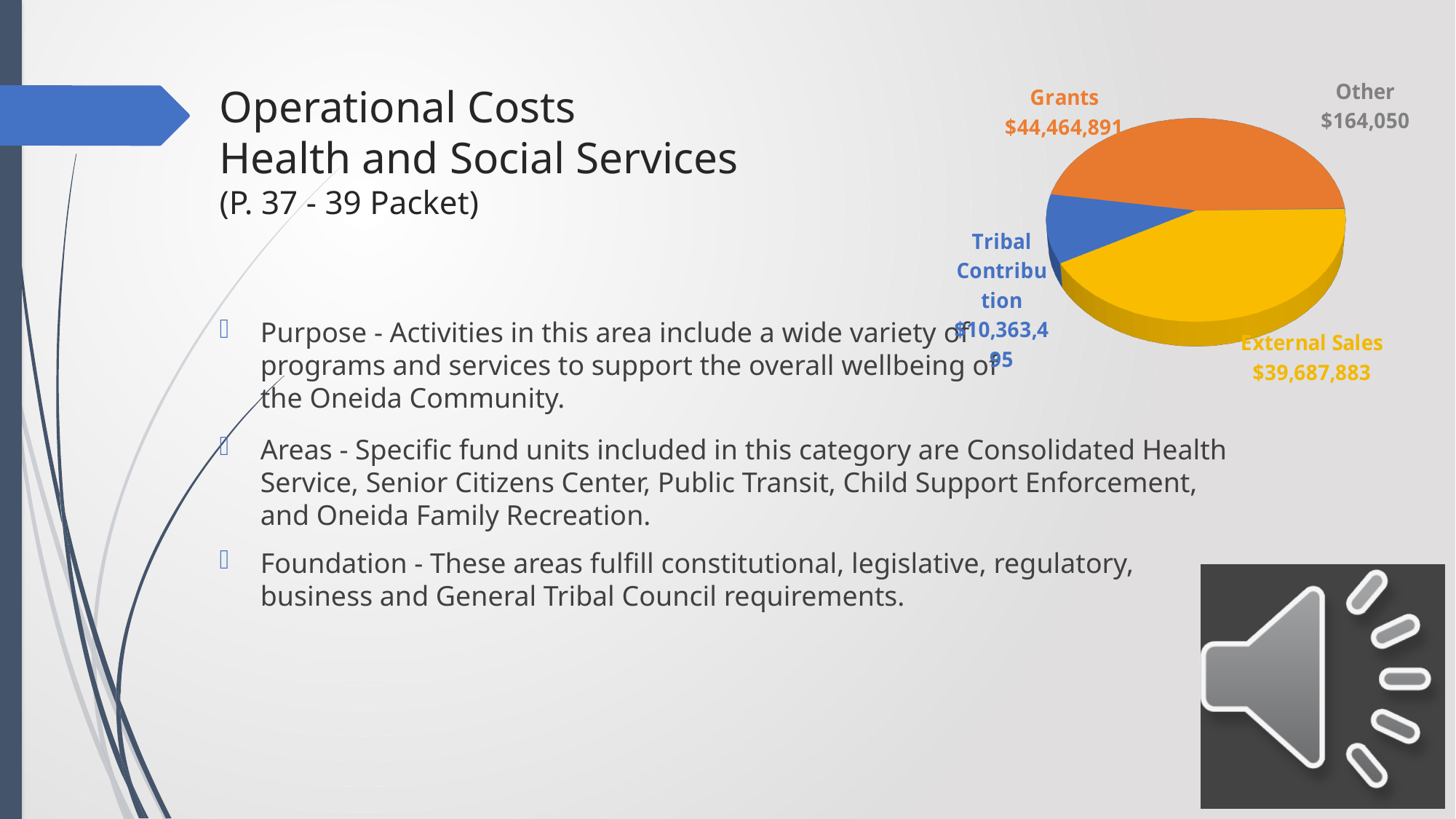
How many slices does the pie chart have? 4 What is the value for External Sales in the pie chart? $39,687,883 Which category has the largest slice in the pie chart? Grants What is the difference between the Grants value and the External Sales value? $4,777,008 Which category has the smallest slice in the pie chart? Other What colour is the External Sales slice in the pie chart? yellow Which is larger, External Sales or Tribal Contribution? External Sales What is the value for Grants in the pie chart? $44,464,891 What kind of chart is shown on the slide? pie chart What colour is the Tribal Contribution slice in the pie chart? blue What is the value for Other in the pie chart? $164,050 What is the value for Tribal Contribution in the pie chart? $10,363,495